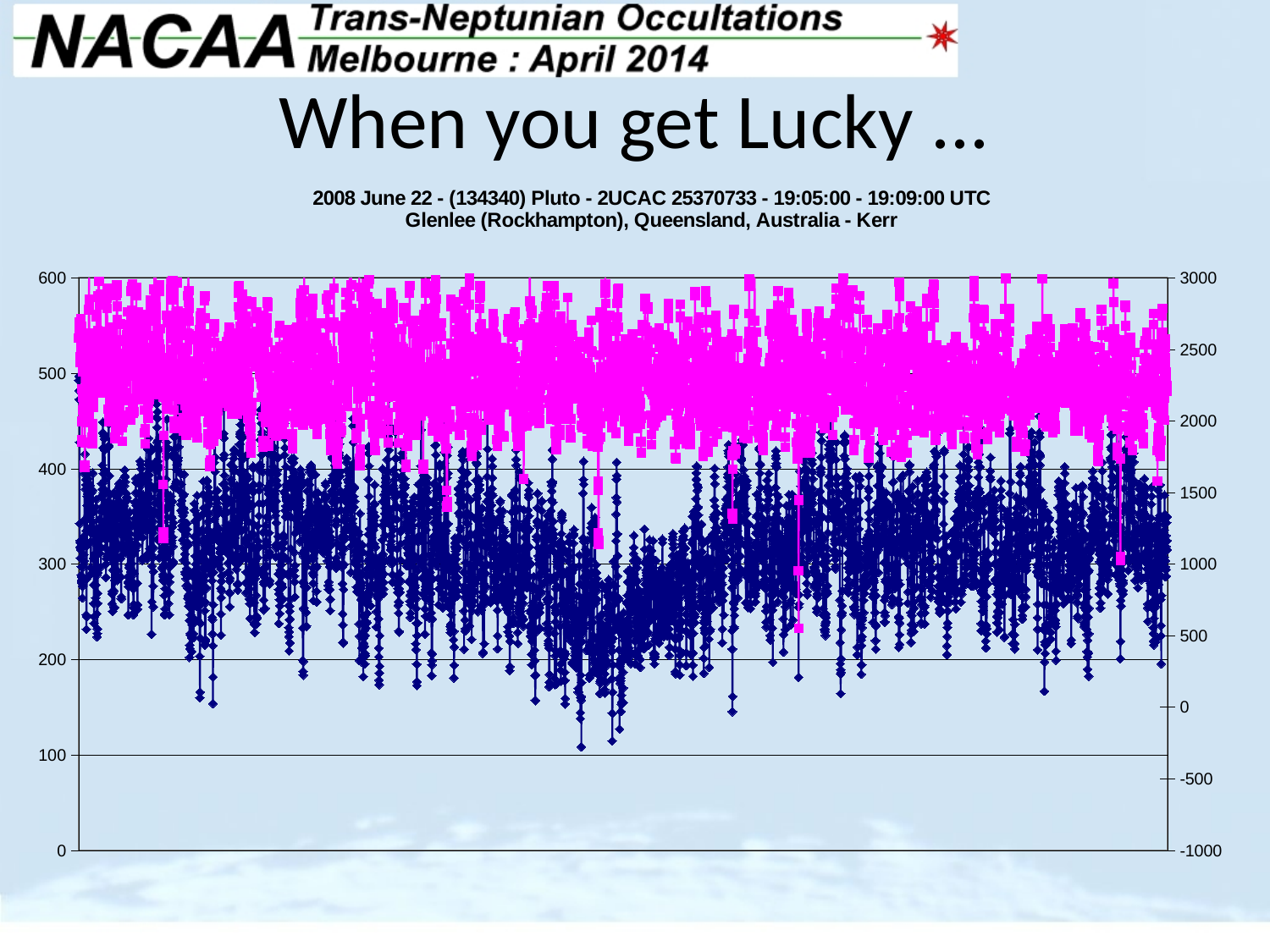
What kind of chart is shown on the slide? line chart Which series generally sits higher on the chart, the magenta series or the dark blue series? the magenta series How many data series are plotted on the chart? 2 What is the lowest value shown on the right vertical axis of the chart? -1000 What is the highest value shown on the left vertical axis of the chart? 600 Is the lowest point of the dark blue series greater or less than 200 on the left axis? less Does the dark blue series ever drop below 200 on the left axis? yes